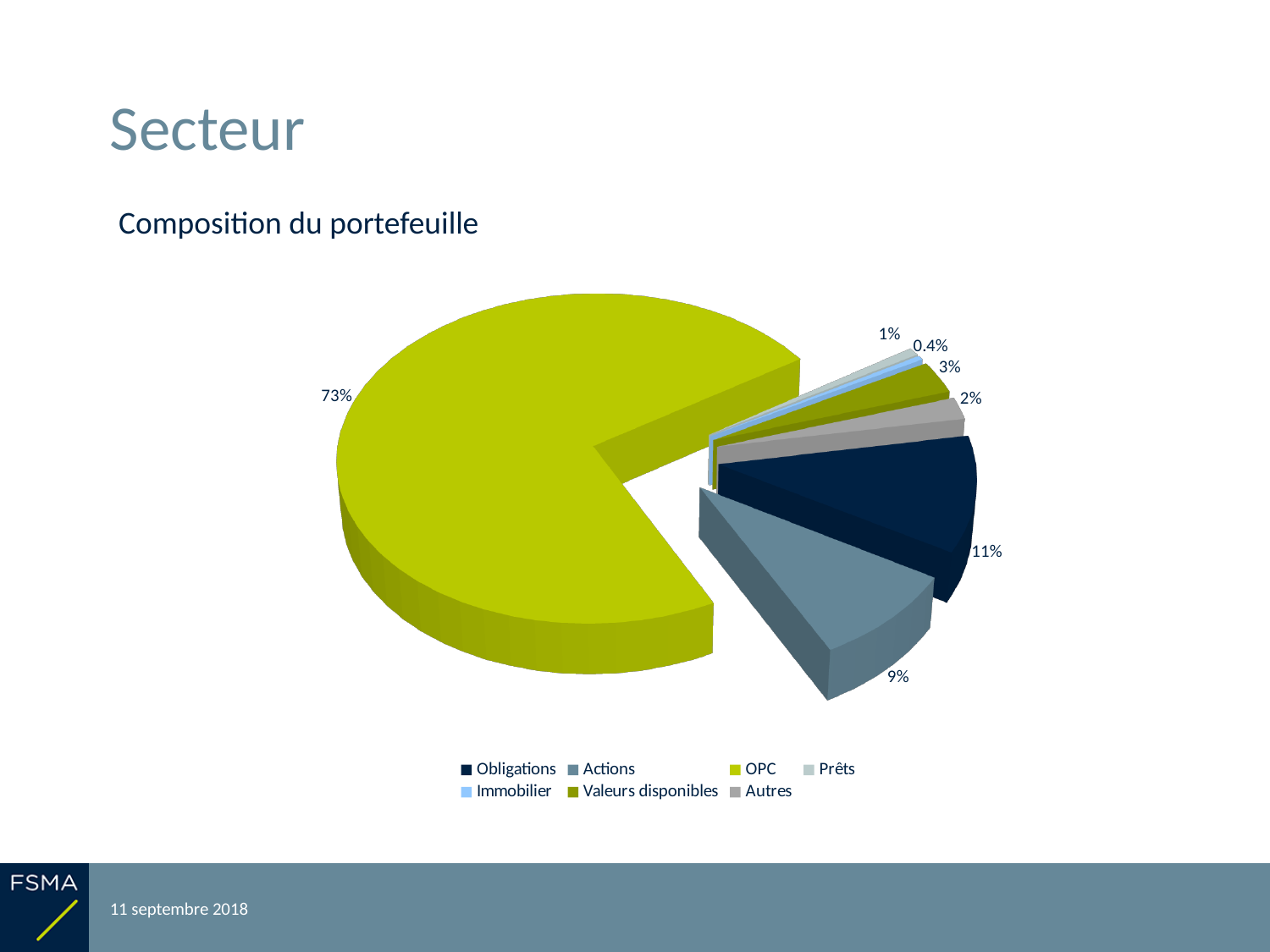
What is the title of the chart? Composition du portefeuille Which is larger, the share for Obligations or the share for Actions? Obligations What share of the portfolio is Actions? 9% Which category has the largest share of the pie? OPC What share of the portfolio is Obligations? 11% What share of the portfolio is OPC? 73% What share of the portfolio is Immobilier? 0.4% Which category has the smallest share of the pie? Immobilier What share of the portfolio is Valeurs disponibles? 3% What kind of chart is shown on the slide? pie chart What is the difference in percentage points between the OPC share and the Obligations share? 62 How many categories does the legend list? 7